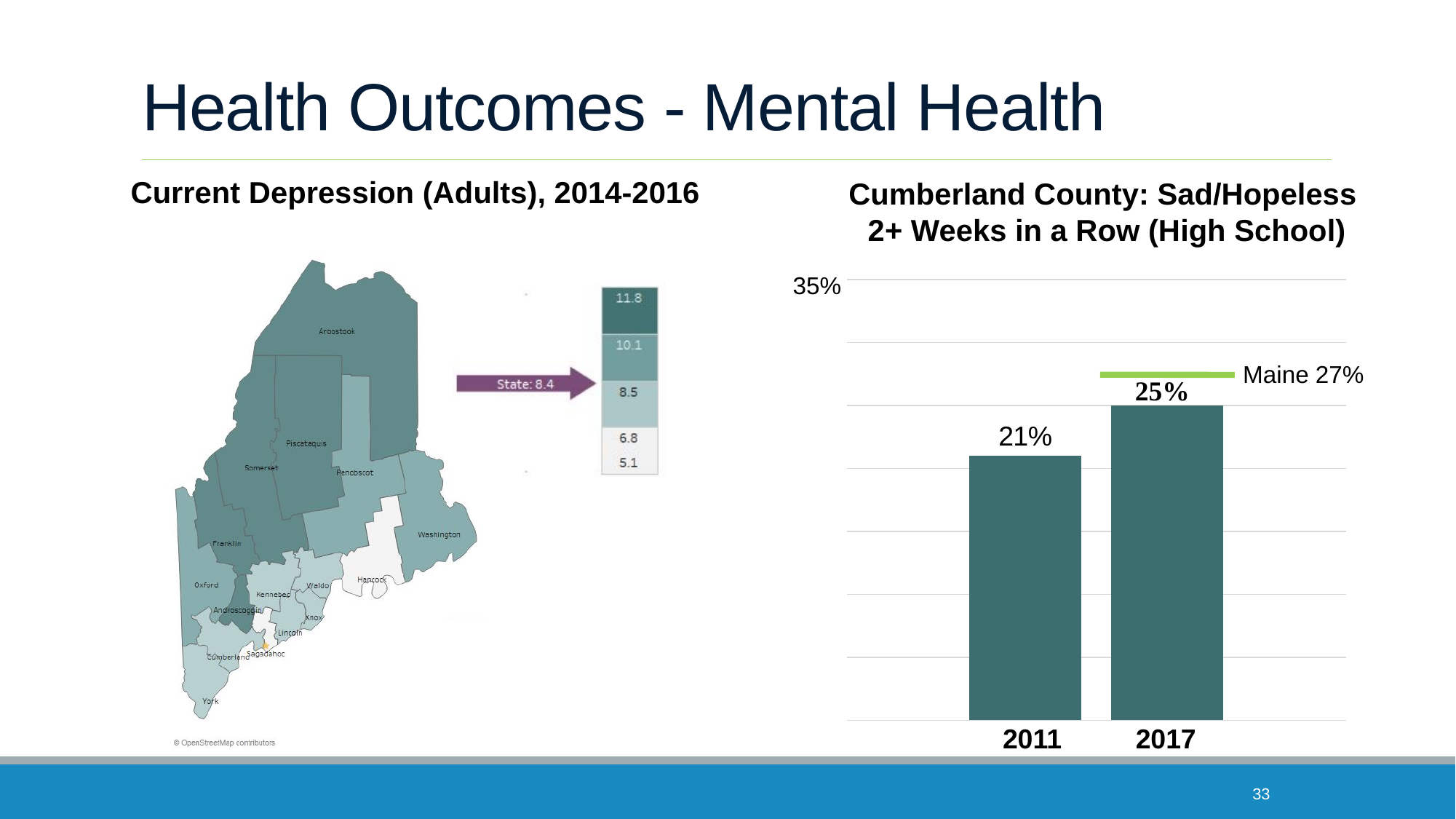
On the Cumberland County: Sad/Hopeless 2+ Weeks in a Row (High School) chart, what is the value for 2017? 25% On the Current Depression (Adults), 2014-2016 map, what state value is indicated by the arrow? 8.4 On the Cumberland County: Sad/Hopeless 2+ Weeks in a Row (High School) chart, what is the Maine reference value shown? 27% On the Cumberland County: Sad/Hopeless 2+ Weeks in a Row (High School) chart, is the 2011 value greater or less than 35%? less On the Cumberland County: Sad/Hopeless 2+ Weeks in a Row (High School) chart, what is the value for 2011? 21% What kind of chart is the Cumberland County: Sad/Hopeless 2+ Weeks in a Row (High School) chart? bar chart On the Cumberland County: Sad/Hopeless 2+ Weeks in a Row (High School) chart, which year has the lower value? 2011 On the Cumberland County: Sad/Hopeless 2+ Weeks in a Row (High School) chart, which year has the higher value? 2017 On the Cumberland County: Sad/Hopeless 2+ Weeks in a Row (High School) chart, is the 2017 value greater or less than the Maine value shown? less On the Cumberland County: Sad/Hopeless 2+ Weeks in a Row (High School) chart, does the value rise or fall from 2011 to 2017? rise On the Cumberland County: Sad/Hopeless 2+ Weeks in a Row (High School) chart, how many bars are plotted? 2 On the Cumberland County: Sad/Hopeless 2+ Weeks in a Row (High School) chart, what is the difference between the 2017 and 2011 values? 4%